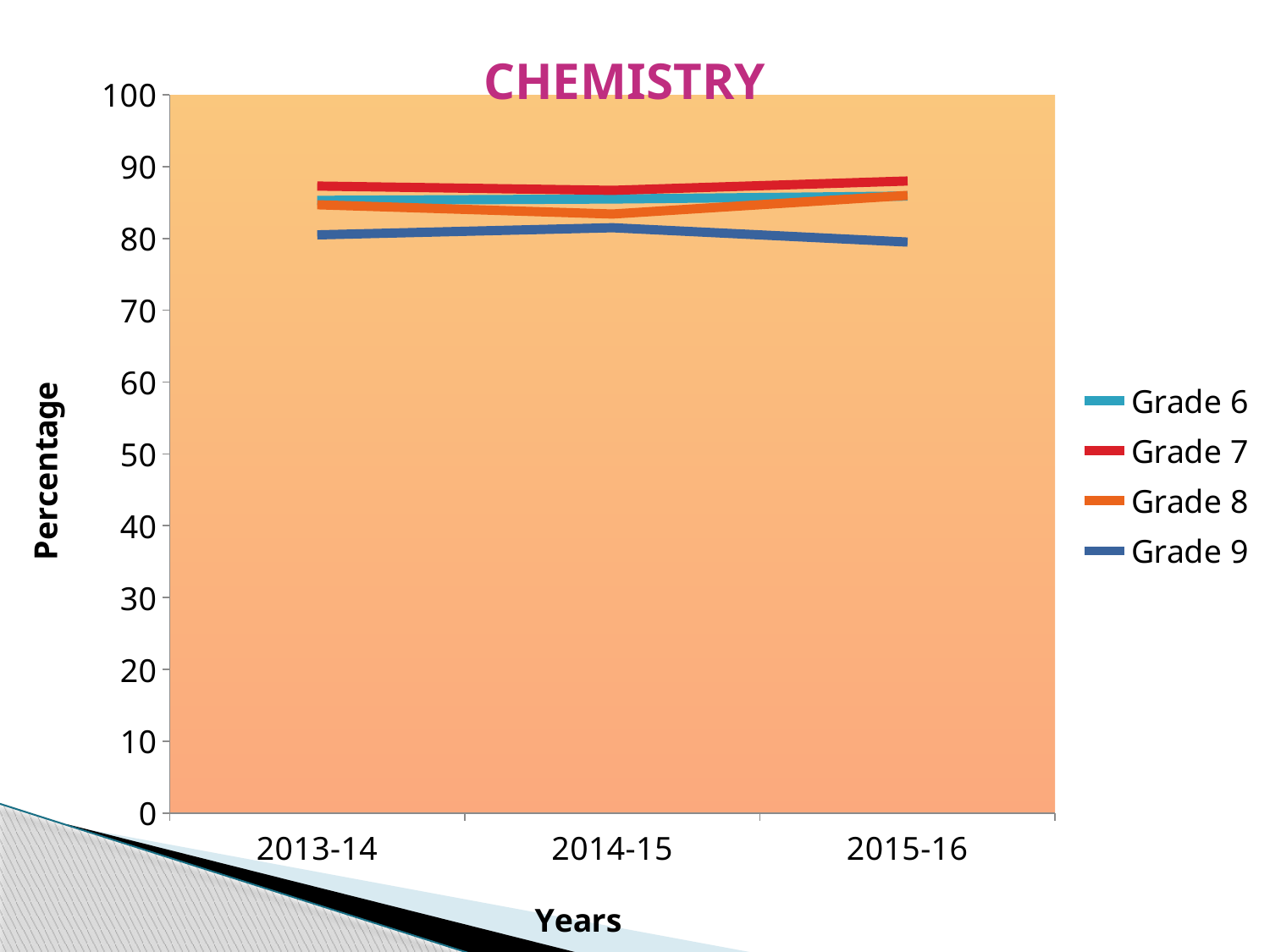
What kind of chart is shown on the slide? line chart Which grade has the highest value in 2015-16? Grade 7 How many years are shown on the x axis? 3 Does the value for Grade 9 rise or fall from 2014-15 to 2015-16? fall What is the label of the vertical axis? Percentage Is the value for Grade 6 in 2015-16 greater or less than 90? less What is the title of the chart? CHEMISTRY How many series does the legend list? 4 Is the value for Grade 7 in 2013-14 greater or less than 80? greater Which grade has the lowest value in 2015-16? Grade 9 In 2013-14, which is larger, the value for Grade 7 or the value for Grade 9? Grade 7